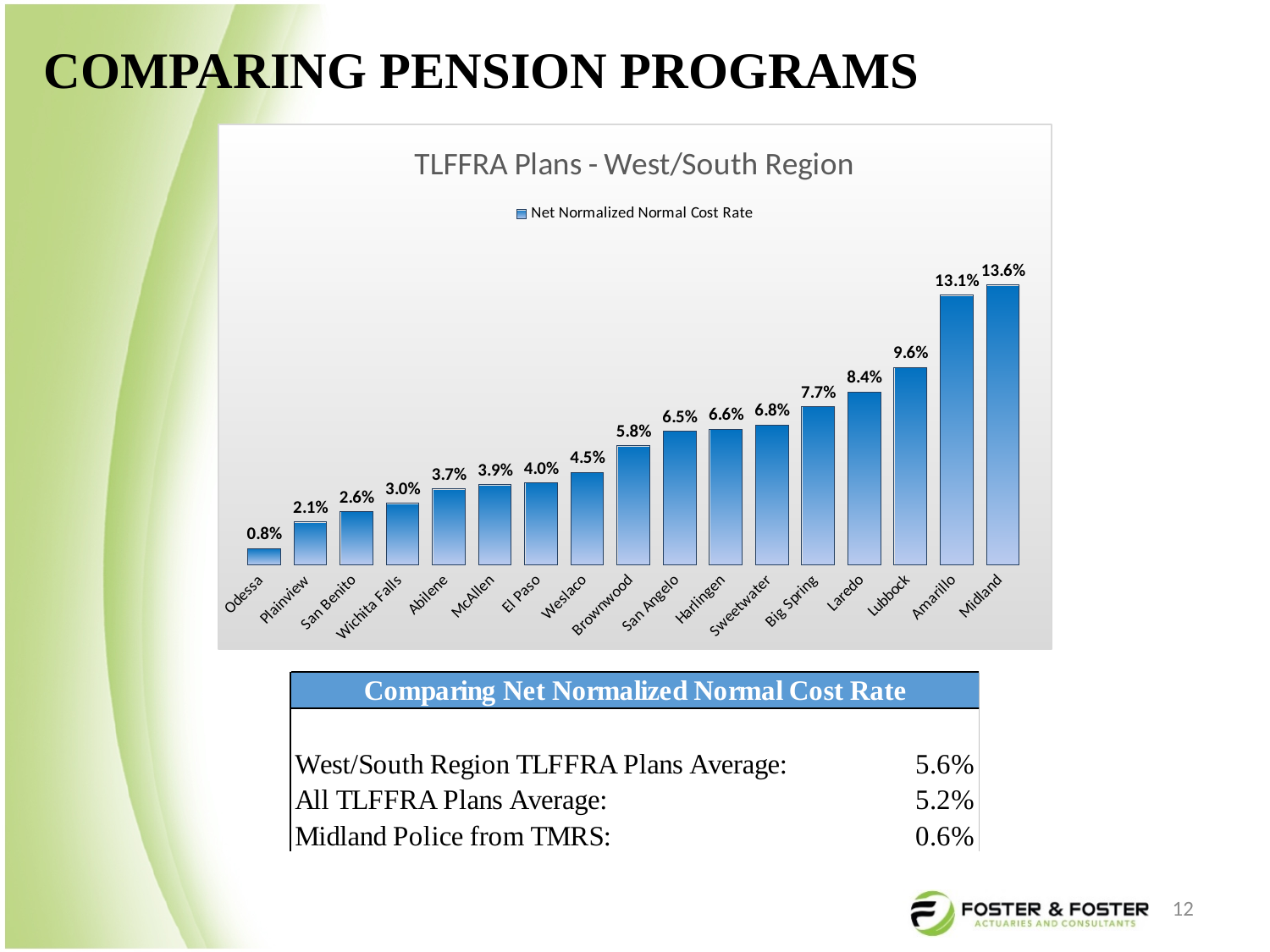
Which plan has the highest Net Normalized Normal Cost Rate? Midland What is the difference between the Net Normalized Normal Cost Rates of Lubbock and Laredo? 1.2% What is the Net Normalized Normal Cost Rate for El Paso? 4.0% What type of chart is used to show the TLFFRA Plans - West/South Region data? Bar chart What is the Net Normalized Normal Cost Rate for Midland? 13.6% How many plans are shown in the chart? 17 What is the difference between the Net Normalized Normal Cost Rates of Midland and Amarillo? 0.5% Do the values rise or fall moving from left to right across the chart? Rise What is the Net Normalized Normal Cost Rate for Odessa? 0.8% What is the Net Normalized Normal Cost Rate for Lubbock? 9.6% Which has a higher Net Normalized Normal Cost Rate, Big Spring or Brownwood? Big Spring Which plan has the lowest Net Normalized Normal Cost Rate? Odessa